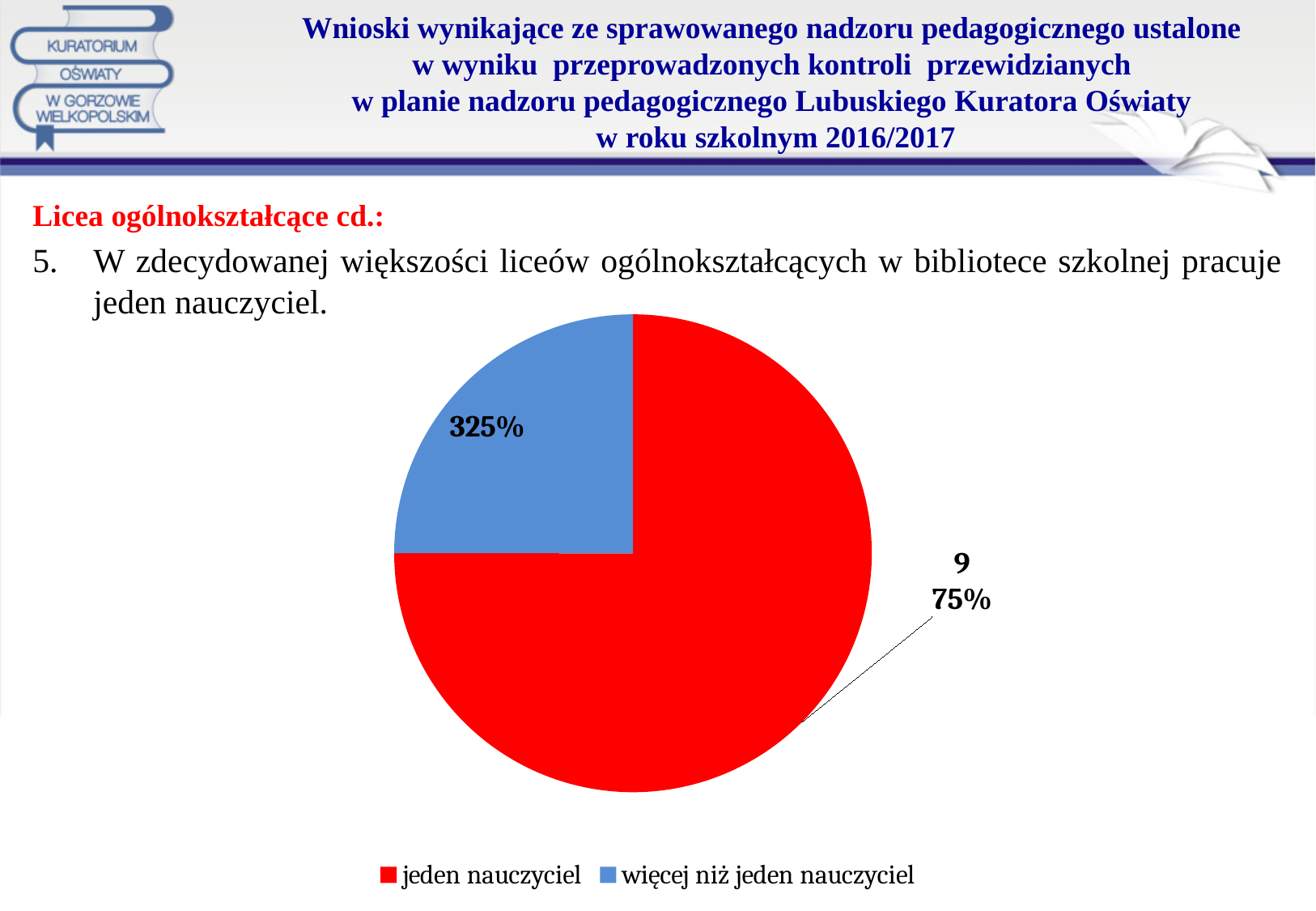
How many entries does the legend of the pie chart list? 2 What count is printed on the data label for the slice 'jeden nauczyciel'? 9 What share of the pie does the slice 'jeden nauczyciel' represent? 75% What colour is the slice for 'jeden nauczyciel' in the pie chart? red Which slice is larger: 'jeden nauczyciel' or 'więcej niż jeden nauczyciel'? jeden nauczyciel How many slices does the pie chart have? 2 What kind of chart is shown on the slide? pie chart What colour is the slice for 'więcej niż jeden nauczyciel' in the pie chart? blue Which slice of the pie chart is the largest? jeden nauczyciel Which slice of the pie chart is the smallest? więcej niż jeden nauczyciel